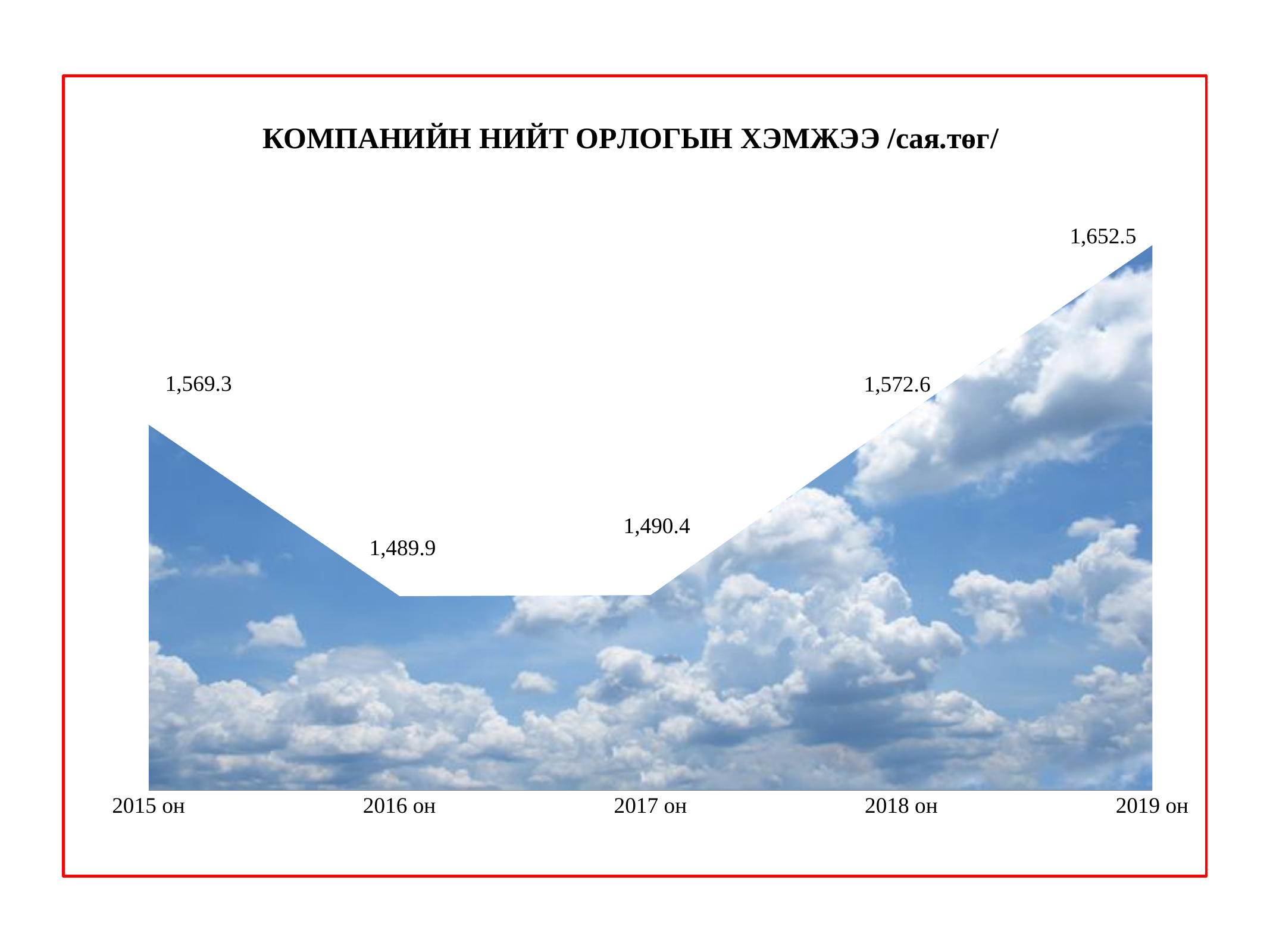
What is the value for 2018 он? 1,572.6 What is the value for 2017 он? 1,490.4 Which year has the highest value? 2019 он What is the value for 2016 он? 1,489.9 Which year has the lowest value? 2016 он What is the difference between the values for 2018 он and 2017 он? 82.2 What is the title of the chart? КОМПАНИЙН НИЙТ ОРЛОГЫН ХЭМЖЭЭ /сая.төг/ What is the value for 2019 он? 1,652.5 What is the value for 2015 он? 1,569.3 What is the difference between the values for 2019 он and 2015 он? 83.2 How many years are shown on the x axis? 5 Which is larger, the value for 2015 он or the value for 2016 он? 2015 он